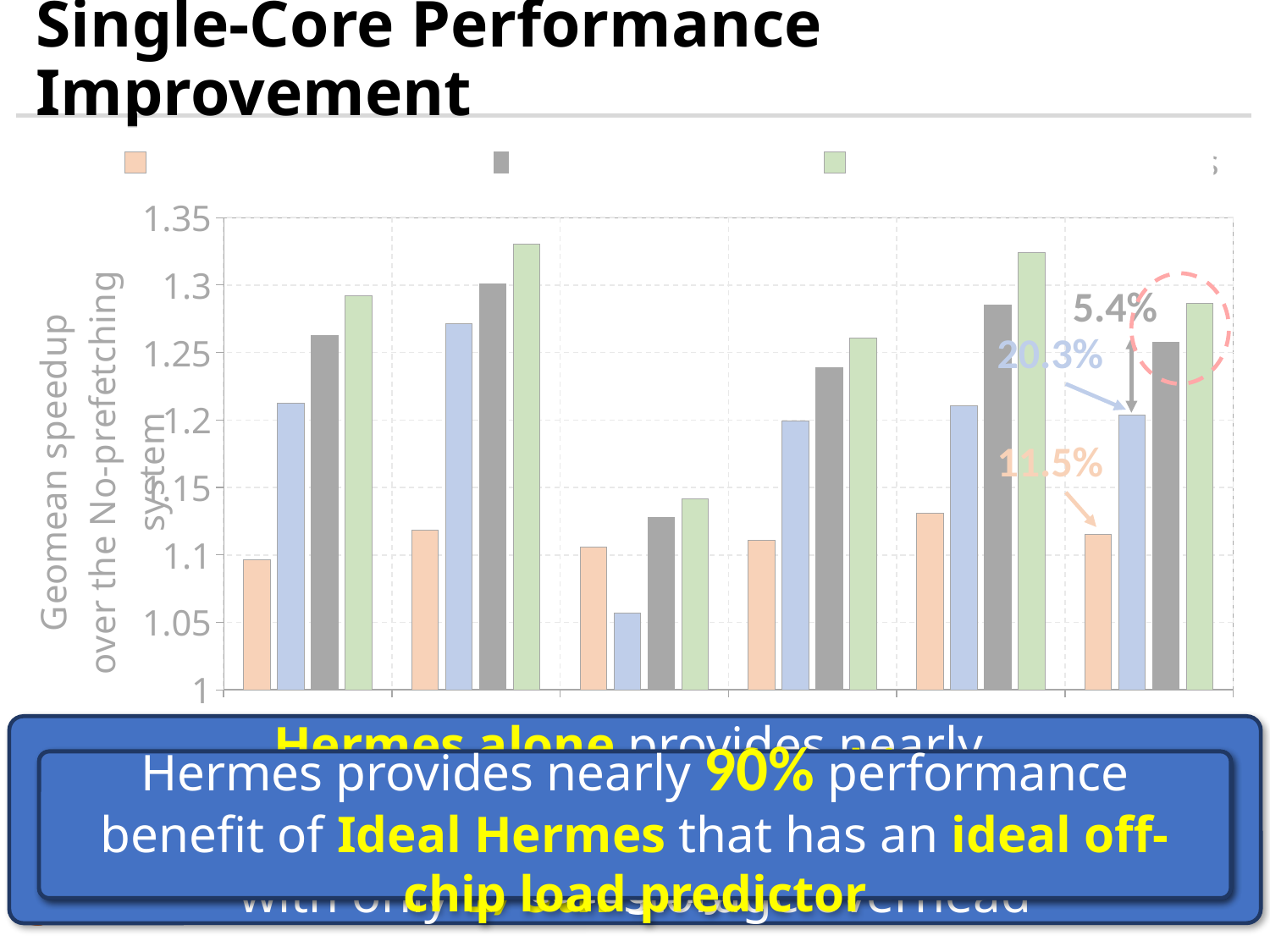
Which colour bar is the lowest in the third group from the left? blue What percentage annotation points to the blue bar in the rightmost group? 20.3% How many bars are there in each group? 4 Which colour bar is the tallest in the leftmost group? green In the rightmost group, which is taller, the gray bar or the green bar? green What is the label of the y axis? Geomean speedup over the No-prefetching system What kind of chart is shown on the slide? bar chart In the third group from the left, is the value of the blue bar greater or less than 1.1? less In the leftmost group, is the value of the green bar greater or less than 1.25? greater In the fifth group from the left, is the value of the gray bar greater or less than 1.25? greater How many groups of bars are plotted along the x axis? 6